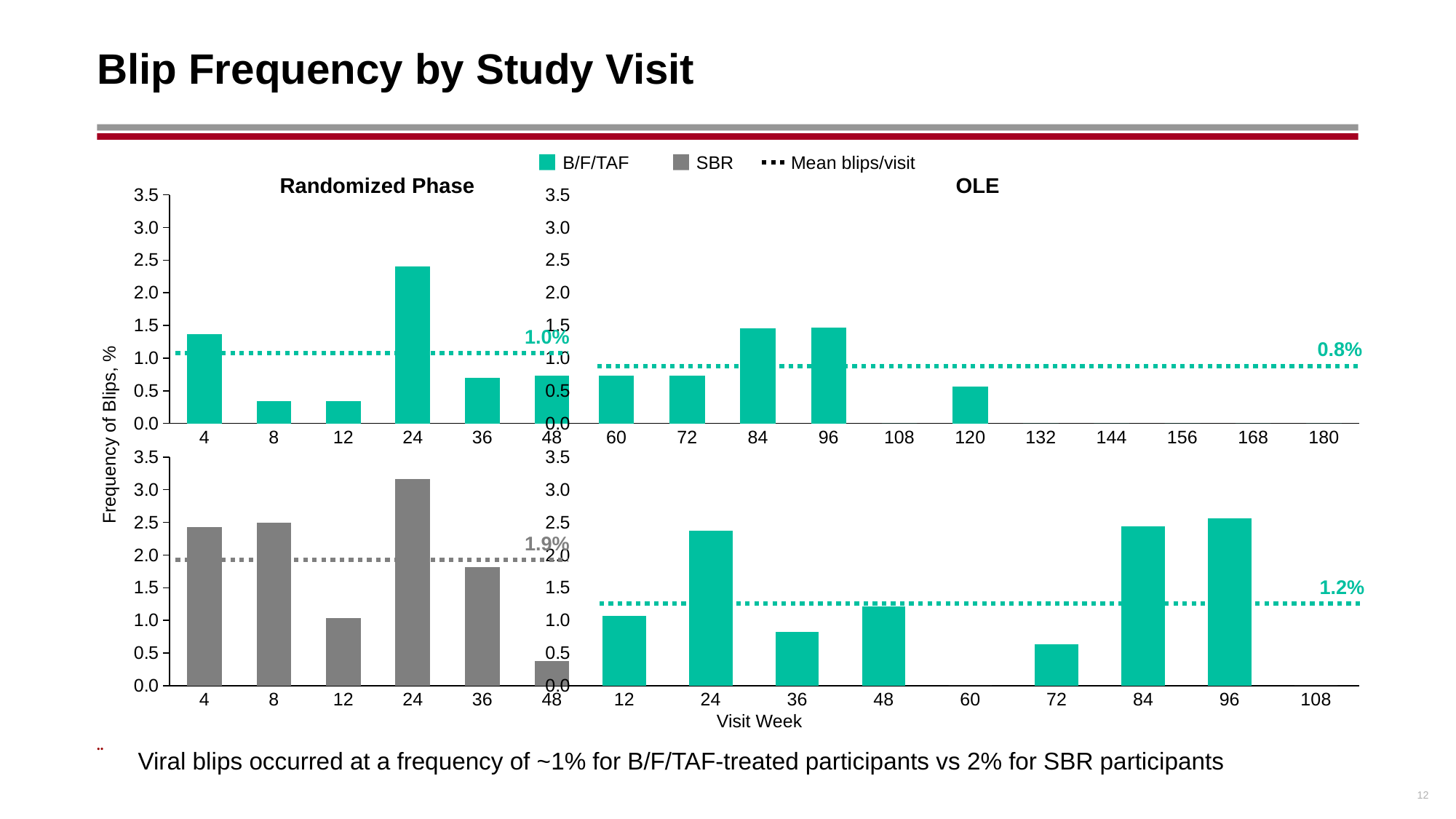
In the top-left Randomized Phase panel (B/F/TAF), is the value at week 24 greater or less than 2.0? greater What is the mean blips/visit value shown in the bottom-right OLE panel? 1.2% In the bottom-left Randomized Phase panel (SBR), which visit week has the highest frequency of blips? 24 In the top-left Randomized Phase panel (B/F/TAF), which is larger, the value at week 4 or the value at week 8? week 4 In the top-left Randomized Phase panel (B/F/TAF), which visit week has the highest frequency of blips? 24 How many bars are plotted in the top-right OLE panel? 5 What is the mean blips/visit value shown in the top-right OLE panel? 0.8% What is the mean blips/visit value shown for SBR in the Randomized Phase (bottom-left panel)? 1.9% How many entries does the legend list? 3 What is the mean blips/visit value shown for B/F/TAF in the Randomized Phase (top-left panel)? 1.0% In the bottom-left Randomized Phase panel (SBR), which visit week has the lowest frequency of blips? 48 In the bottom-left Randomized Phase panel (SBR), is the value at week 24 greater or less than 3.0? greater